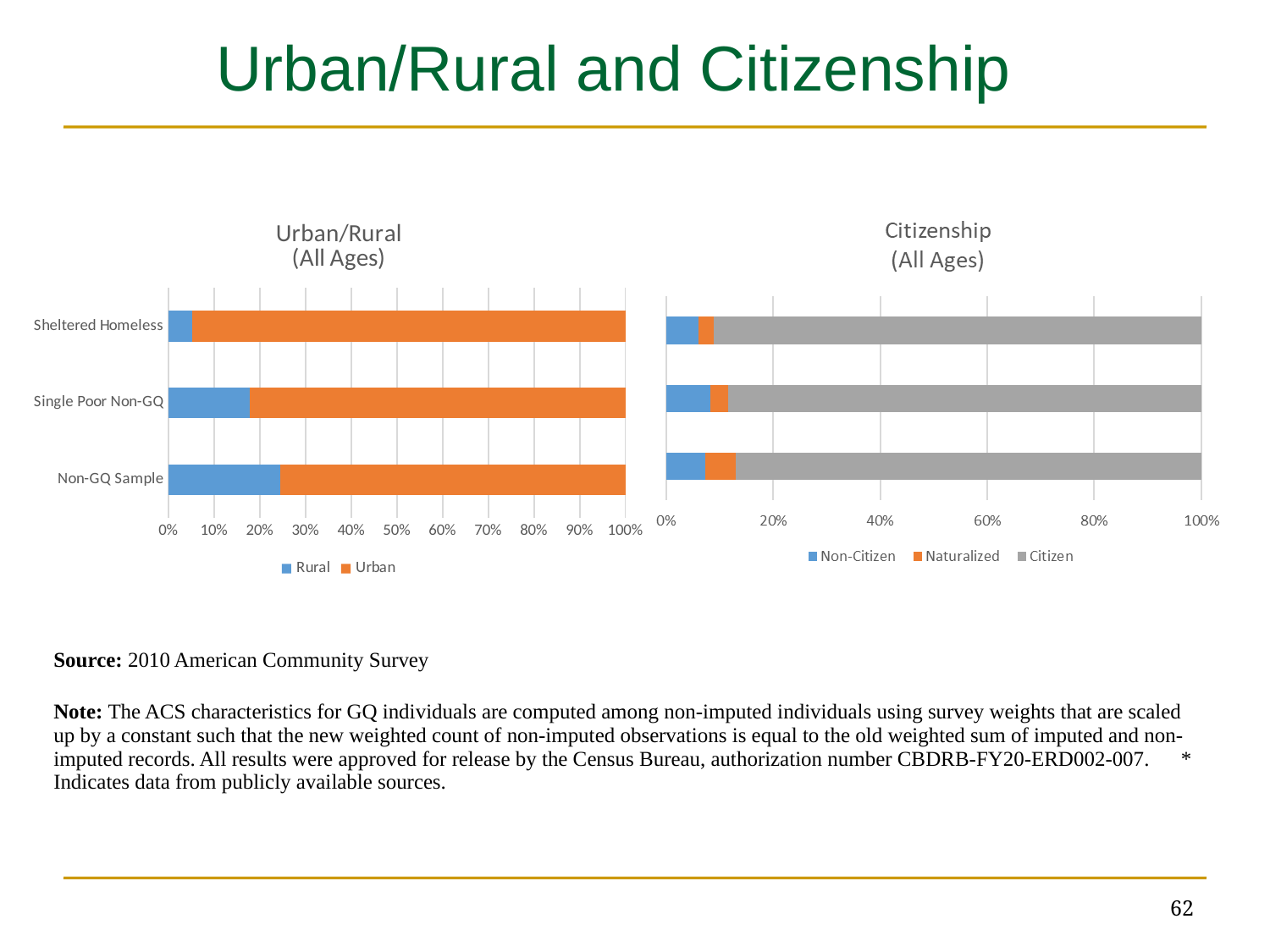
What are the legend entries of the Citizenship (All Ages) chart? Non-Citizen, Naturalized, Citizen How many series does the legend of the Citizenship (All Ages) chart list? 3 In the Urban/Rural (All Ages) chart, which is larger for Single Poor Non-GQ: the Rural share or the Urban share? Urban In the Urban/Rural (All Ages) chart, is the Rural value for Sheltered Homeless greater or less than 10%? less In the Citizenship (All Ages) chart, is the Citizen value for Sheltered Homeless greater or less than 80%? greater In the Citizenship (All Ages) chart, which category has the largest Naturalized share? Non-GQ Sample What kind of chart is the Urban/Rural (All Ages) chart? Stacked bar chart How many series does the legend of the Urban/Rural (All Ages) chart list? 2 In the Urban/Rural (All Ages) chart, which category has the highest Rural share? Non-GQ Sample How many categories are shown on the Citizenship (All Ages) chart? 3 In the Urban/Rural (All Ages) chart, is the Rural value for Non-GQ Sample greater or less than 20%? greater In the Urban/Rural (All Ages) chart, which category has the lowest Rural share? Sheltered Homeless